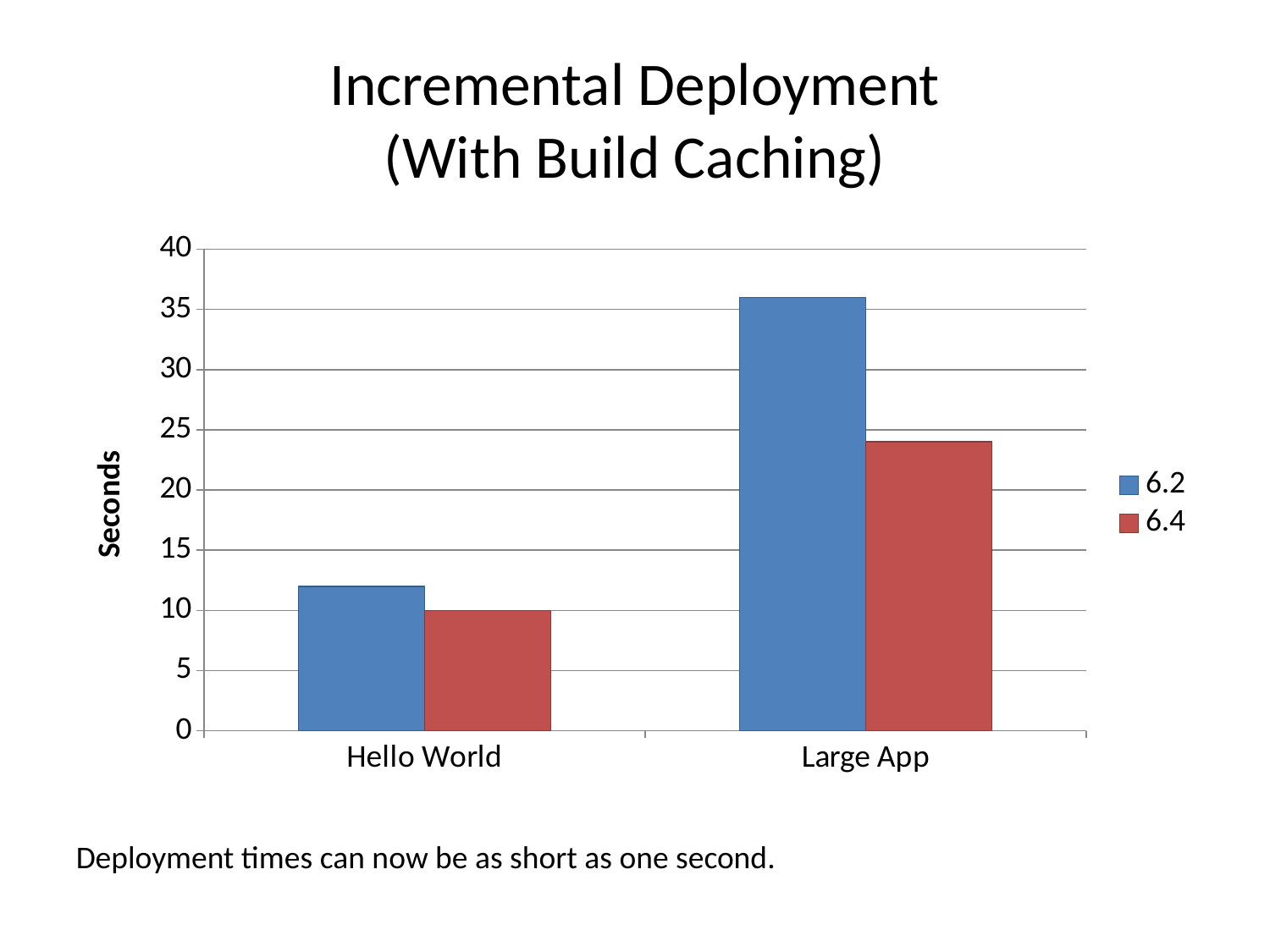
Which category has the lowest value for the 6.4 series? Hello World Is the value for 6.2 in the Large App category greater or less than 35? greater Which category has the highest value for the 6.2 series? Large App What colour are the bars for the 6.4 series? red What kind of chart is shown on the slide? bar chart How many categories are shown on the x axis? 2 What is the label of the vertical axis? Seconds How many series does the legend list? 2 Is the value for 6.2 in the Hello World category greater or less than 10? greater In the Large App category, which series has the larger value, 6.2 or 6.4? 6.2 Is the value for 6.4 in the Large App category greater or less than 25? less What is the value for 6.4 in the Hello World category? 10